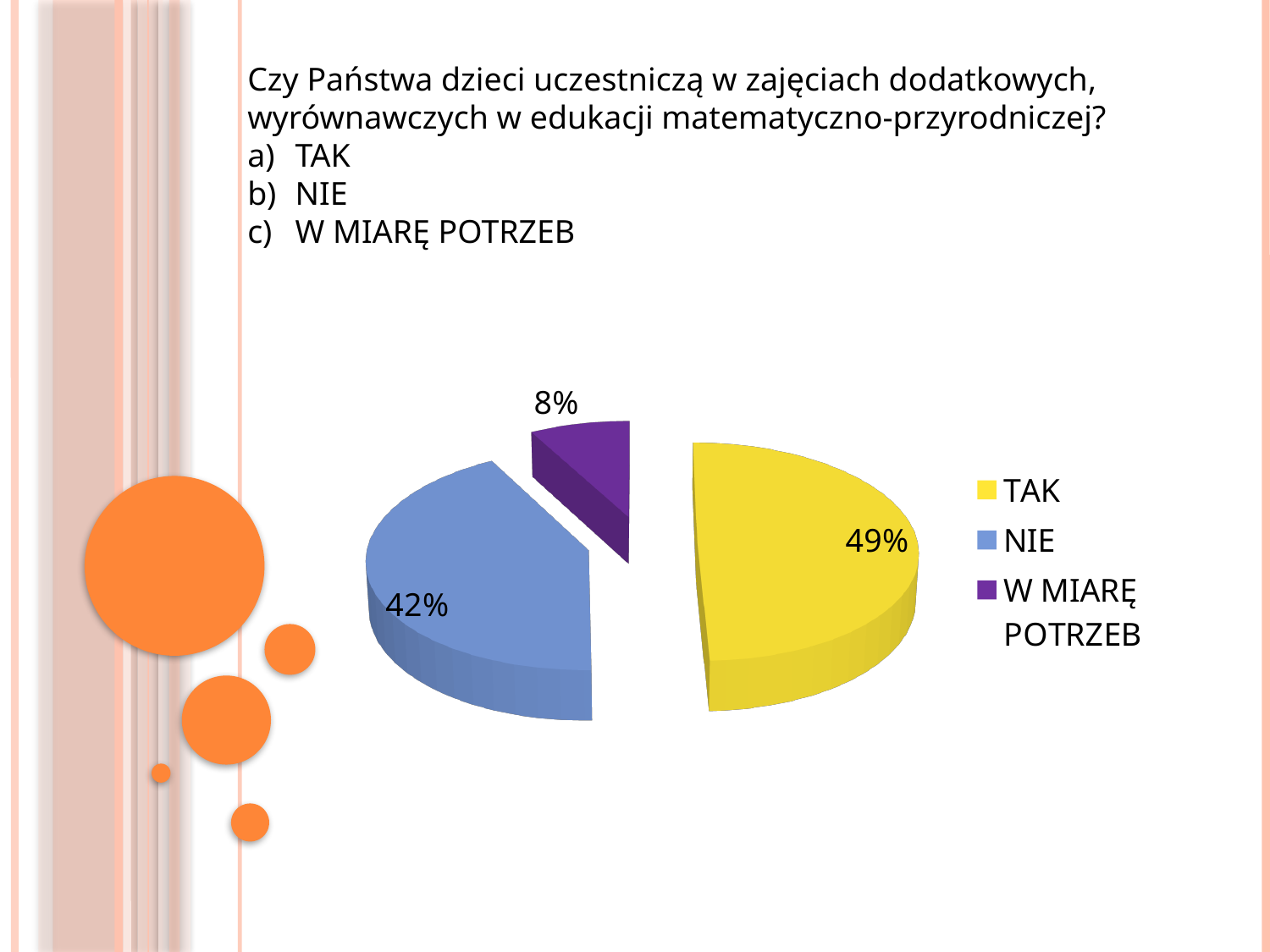
Which category has the smallest slice of the pie? W MIARĘ POTRZEB Which is larger, the share for TAK or the share for NIE? TAK What share of the pie does W MIARĘ POTRZEB have? 8% How many entries does the legend list? 3 What is the difference in percentage points between TAK and NIE? 7 What colour is the slice for NIE? Blue What is the difference in percentage points between NIE and W MIARĘ POTRZEB? 34 What kind of chart is shown on the slide? Pie chart Which category has the largest slice of the pie? TAK How many slices does the pie chart have? 3 What share of the pie does TAK have? 49% What share of the pie does NIE have? 42%